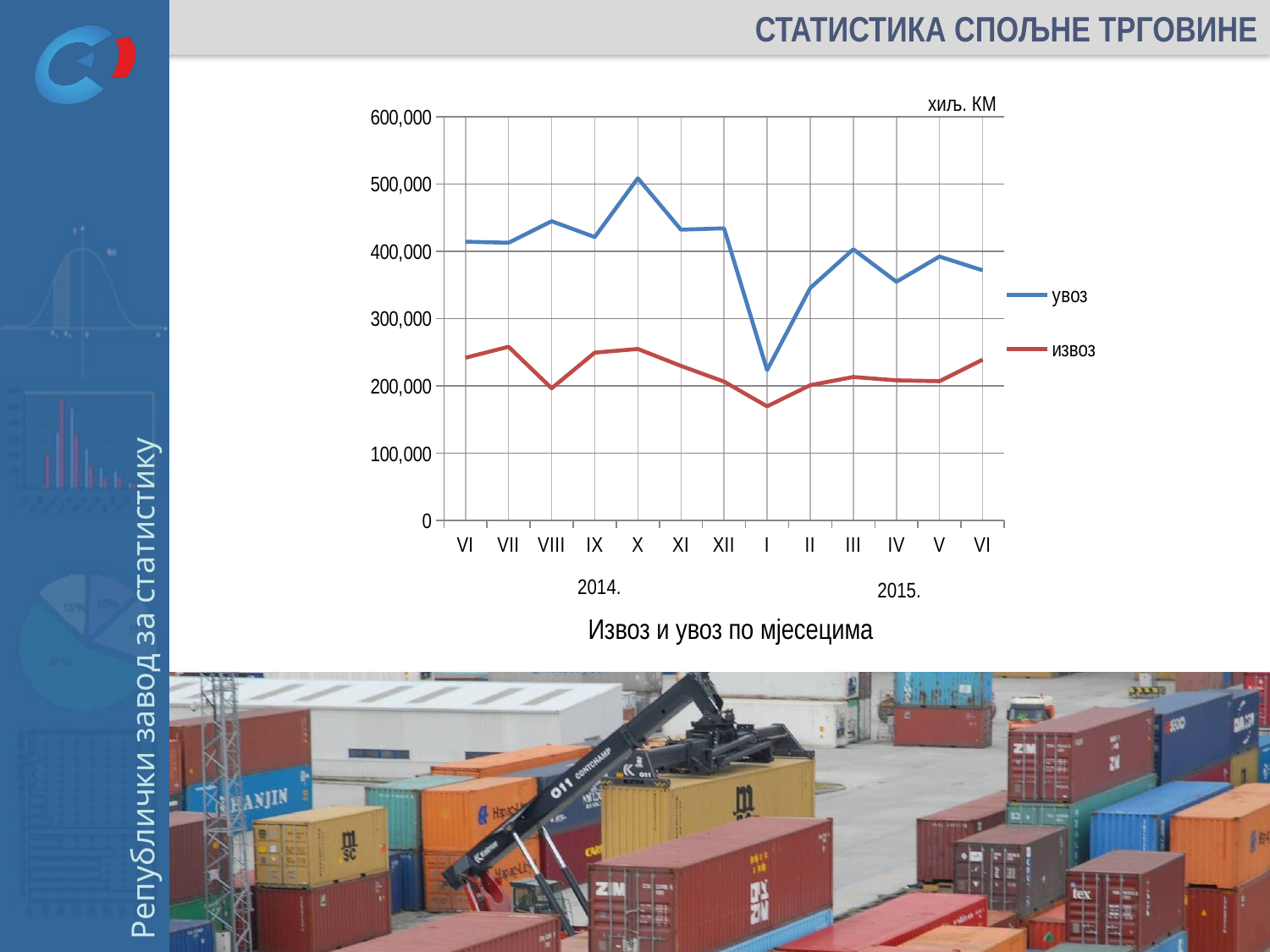
What unit is shown above the chart's y axis? хиљ. КМ In which month does the увоз series reach its highest value? X 2014. What kind of chart is shown on the slide? line chart Which series has the larger value in VI 2015., увоз or извоз? увоз Is the value of извоз for I 2015. greater or less than 200,000? less Is the value of увоз for X 2014. greater or less than 500,000? greater Is the value of увоз for I 2015. greater or less than 300,000? less Does the увоз series rise or fall from XII 2014. to I 2015.? fall In which month does the увоз series reach its lowest value? I 2015. How many series does the legend list? 2 How many months are plotted along the x axis? 13 In which month does the извоз series reach its lowest value? I 2015.